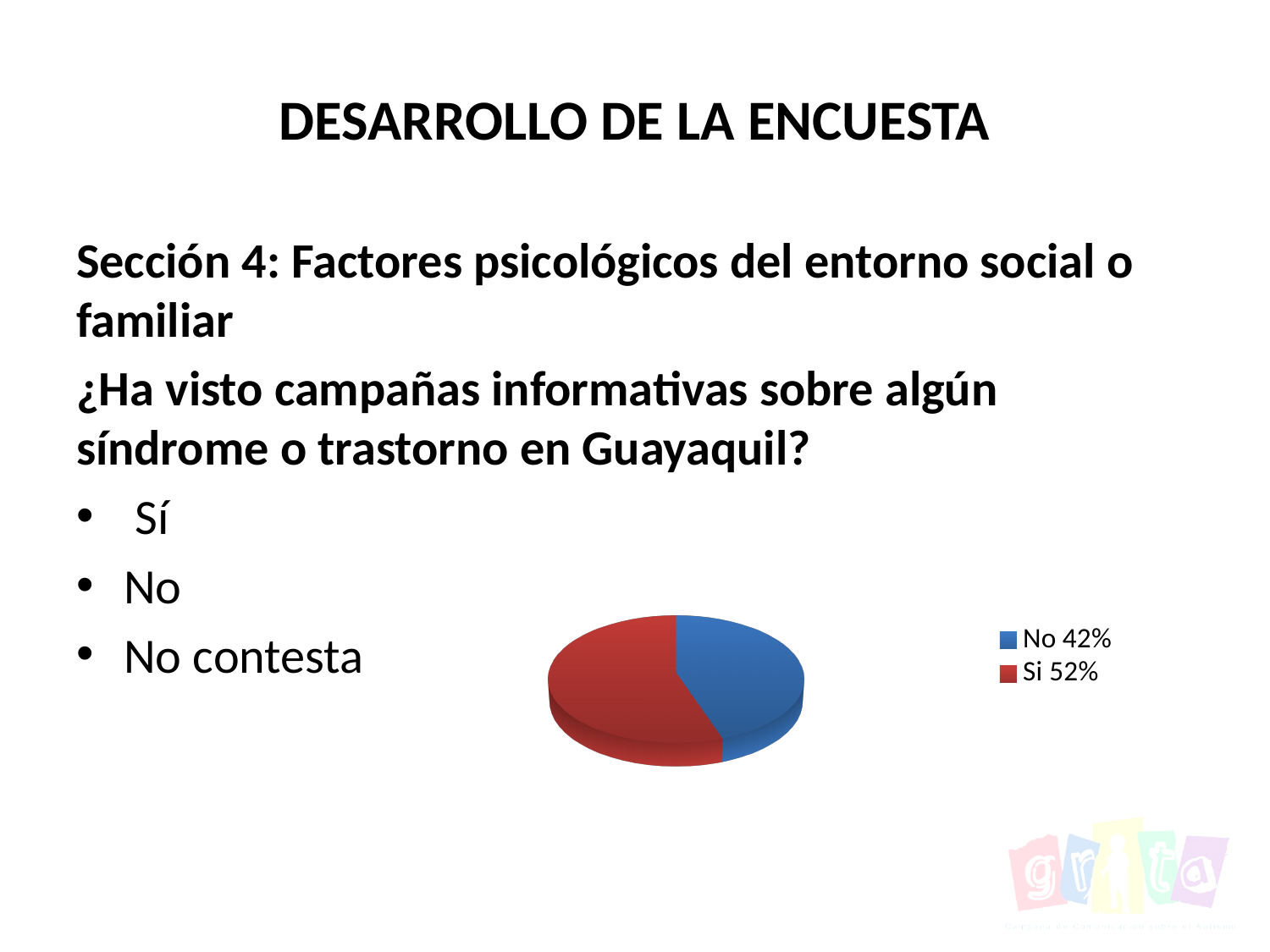
What percentage is shown for "Si" in the pie chart legend? 52% What is the difference in percentage points between "Si" and "No" in the pie chart? 10 What share of the pie does the "No" slice represent according to the legend? 42% What colour is the "Si" slice in the pie chart? red Which category has the smallest slice in the pie chart? No How many entries does the pie chart legend list? 2 What percentage is shown for "No" in the pie chart legend? 42% Which category has the largest slice in the pie chart? Si What kind of chart is shown on the slide? pie chart What colour is the "No" slice in the pie chart? blue Which is larger in the pie chart, "Si" or "No"? Si How many slices does the pie chart have? 2